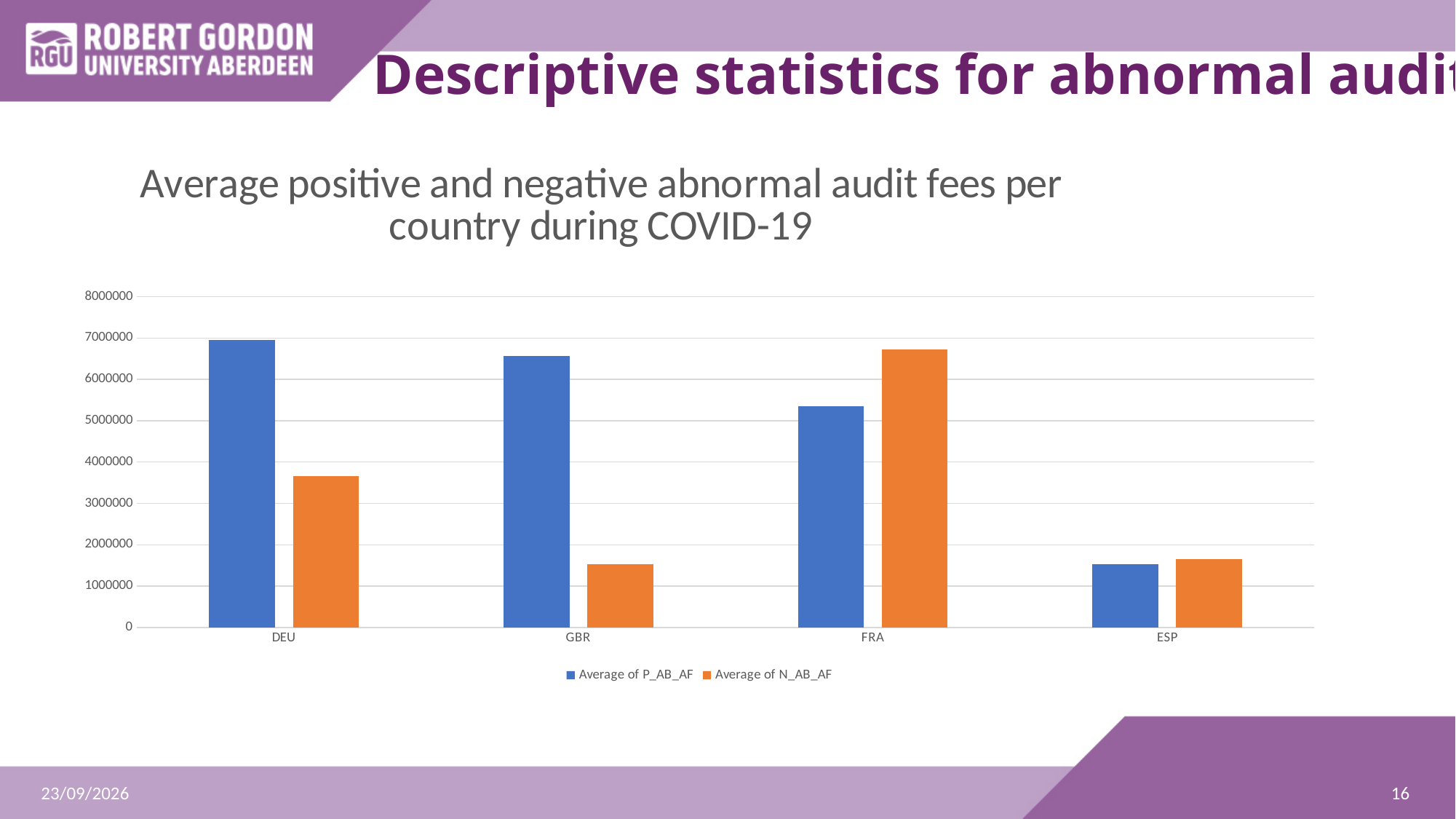
Is the value for Average of P_AB_AF for DEU greater or less than 6000000? greater For DEU, which is larger: Average of P_AB_AF or Average of N_AB_AF? Average of P_AB_AF What kind of chart is shown on the slide? bar chart Which country has the highest value for Average of P_AB_AF? DEU Which country has the highest value for Average of N_AB_AF? FRA For FRA, which is larger: Average of P_AB_AF or Average of N_AB_AF? Average of N_AB_AF How many series does the chart's legend list? 2 What is the title of the chart? Average positive and negative abnormal audit fees per country during COVID-19 How many countries are shown on the x axis of the chart? 4 Is the value for Average of N_AB_AF for GBR greater or less than 2000000? less Which country has the lowest value for Average of P_AB_AF? ESP Is the value for Average of N_AB_AF for DEU greater or less than 4000000? less